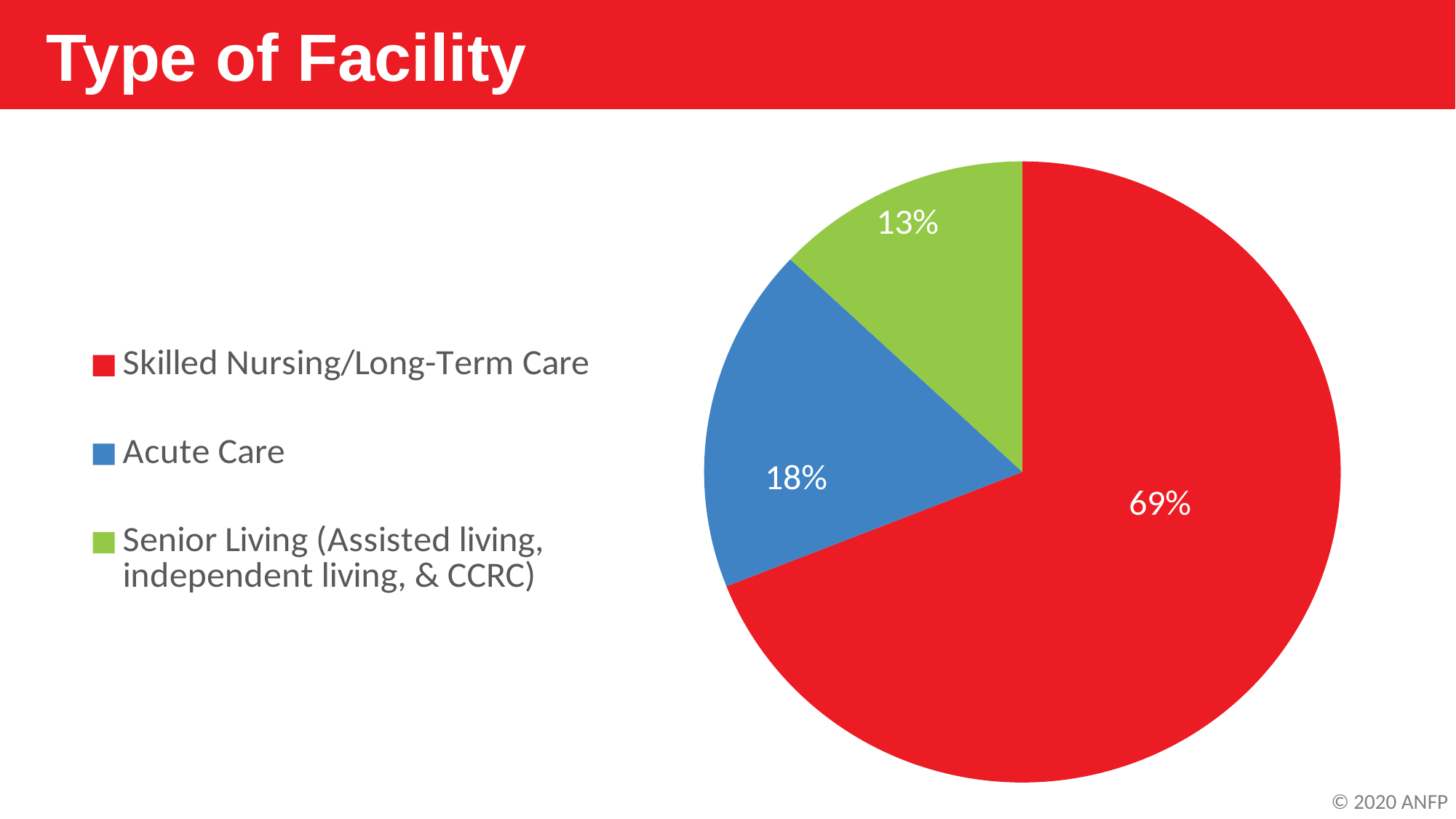
What is the difference in percentage points between Skilled Nursing/Long-Term Care and Acute Care? 51 What share of the pie is Skilled Nursing/Long-Term Care? 69% What is the title of the slide containing the pie chart? Type of Facility What is the difference in percentage points between Acute Care and Senior Living? 5 How many categories does the pie chart show? 3 Which facility type has the smallest slice of the pie? Senior Living (Assisted living, independent living, & CCRC) What colour is the Acute Care slice? blue Which is larger, the Acute Care slice or the Senior Living slice? Acute Care What share of the pie is Acute Care? 18% Which facility type has the largest slice of the pie? Skilled Nursing/Long-Term Care What kind of chart is shown on the slide? pie chart What share of the pie is Senior Living (Assisted living, independent living, & CCRC)? 13%